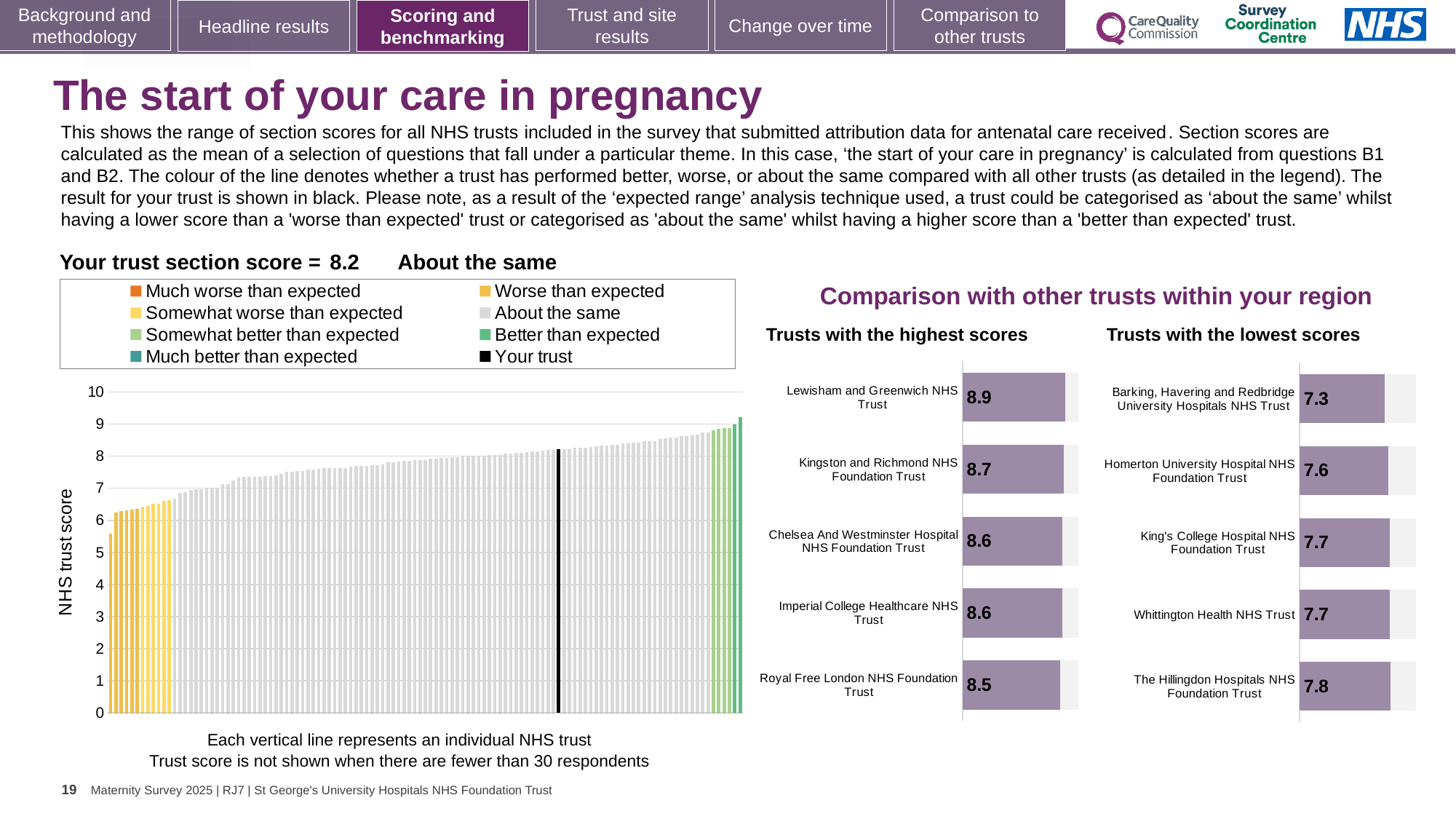
In the 'Trusts with the lowest scores' chart, which trust has the lowest score? Barking, Havering and Redbridge University Hospitals NHS Trust In the main 'NHS trust score' chart, do the values rise or fall from left to right? rise In the 'Trusts with the highest scores' chart, which has the higher score: Kingston and Richmond NHS Foundation Trust or Chelsea And Westminster Hospital NHS Foundation Trust? Kingston and Richmond NHS Foundation Trust In the 'Trusts with the highest scores' chart, what is the difference between the scores of Lewisham and Greenwich NHS Trust and Royal Free London NHS Foundation Trust? 0.4 How many entries does the legend of the main 'NHS trust score' chart list? 8 In the 'Trusts with the highest scores' chart, what is the score for Lewisham and Greenwich NHS Trust? 8.9 What kind of chart is the main 'NHS trust score' chart on the left of the slide? bar chart In the 'Trusts with the lowest scores' chart, what is the difference between the scores of The Hillingdon Hospitals NHS Foundation Trust and Barking, Havering and Redbridge University Hospitals NHS Trust? 0.5 In the 'Trusts with the highest scores' chart, which trust has the highest score? Lewisham and Greenwich NHS Trust According to the slide, what is your trust's section score for the start of your care in pregnancy? 8.2 How many trusts are listed in the 'Trusts with the lowest scores' chart? 5 In the 'Trusts with the lowest scores' chart, what is the score for Barking, Havering and Redbridge University Hospitals NHS Trust? 7.3